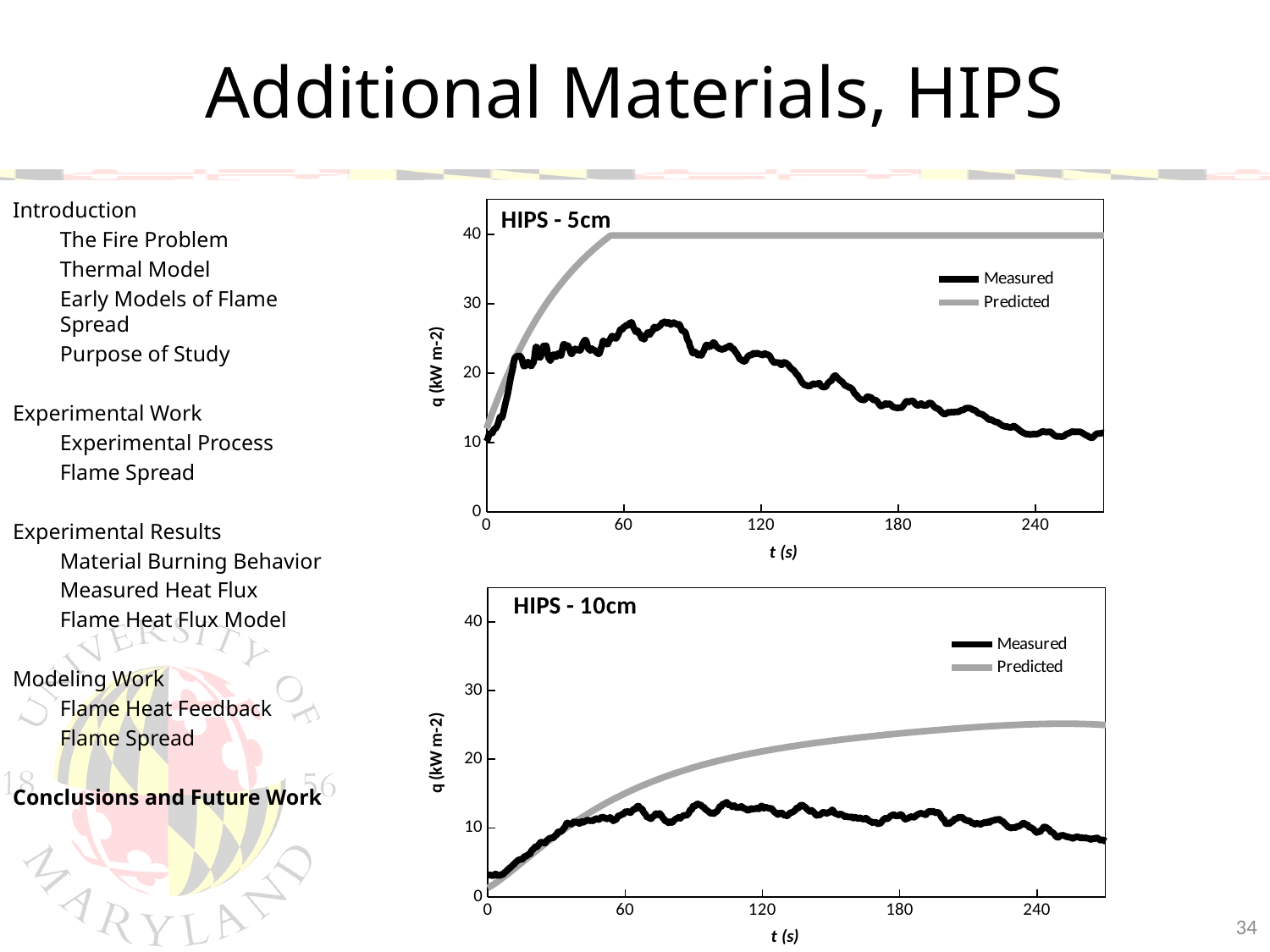
In the HIPS - 5cm chart, at t = 180 s, which series has the larger value, Measured or Predicted? Predicted In the HIPS - 5cm chart, does the Measured curve ever exceed 30? No What kind of chart is the HIPS - 5cm chart? line chart In the HIPS - 10cm chart, does the Predicted curve generally rise or fall as t increases? rise In the HIPS - 5cm chart, is the Measured value at t = 240 s greater or less than 20? less In the HIPS - 10cm chart, is the Measured value at t = 180 s greater or less than 20? less What is the label of the x axis on the HIPS - 10cm chart? t (s) In the HIPS - 5cm chart, does the Measured curve rise or fall between t = 120 s and t = 240 s? fall How many series does the legend of the HIPS - 10cm chart list? 2 In the HIPS - 10cm chart, at t = 240 s, which series has the larger value, Measured or Predicted? Predicted